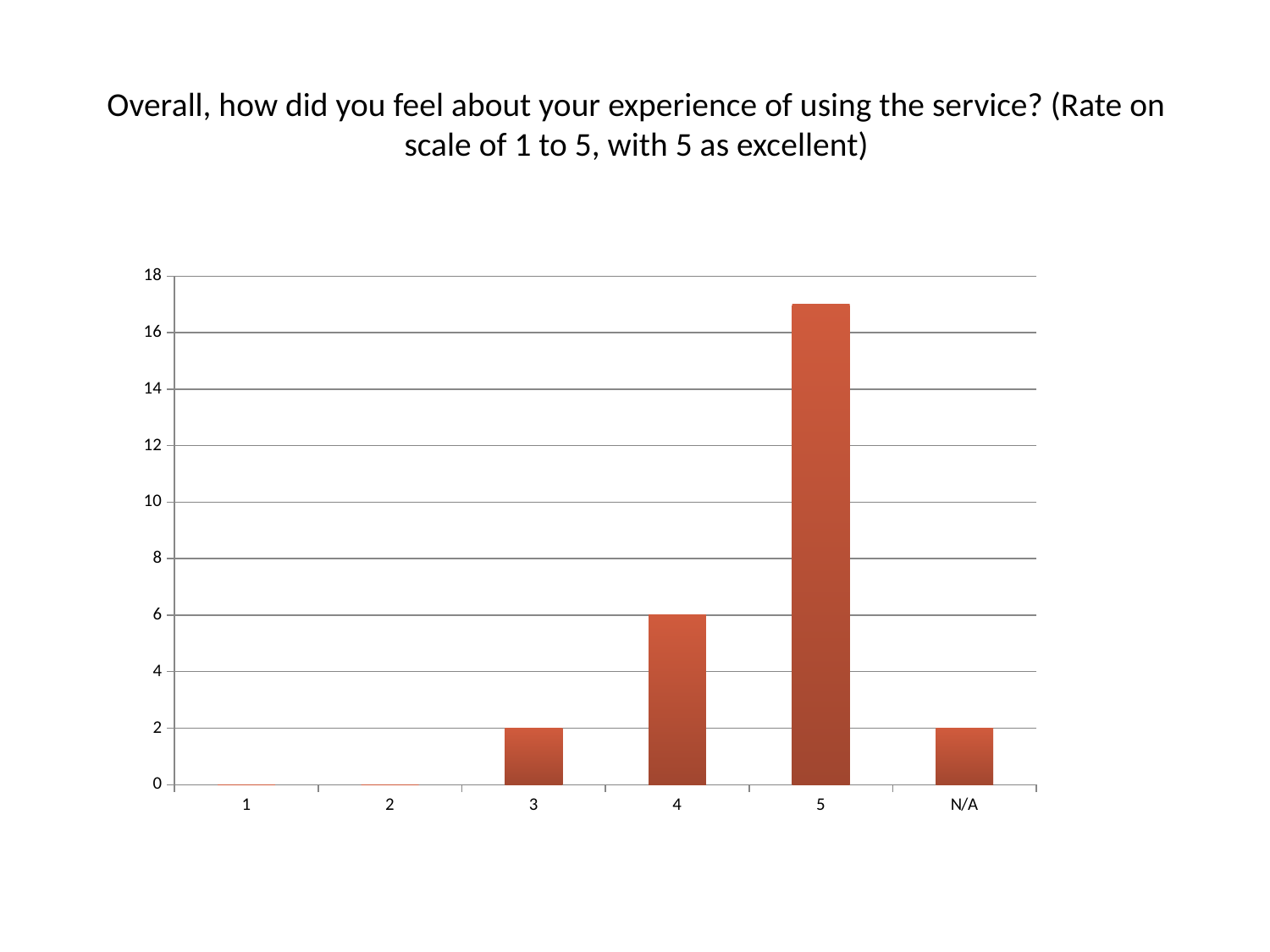
Is the value for rating 4 greater or less than 10? less How many categories are shown on the x axis? 6 What kind of chart is shown on the slide? bar chart Is the value for rating 5 greater or less than 16? greater Which rating category has the highest bar? 5 What is the value for N/A? 2 What is the value for rating 4? 6 What is the value for rating 3? 2 What is the title of the chart? Overall, how did you feel about your experience of using the service? (Rate on scale of 1 to 5, with 5 as excellent) Do the values rise or fall as the rating goes from 1 to 5? rise Which is larger, the value for rating 4 or the value for rating 3? rating 4 What is the difference between the value for rating 4 and the value for rating 3? 4